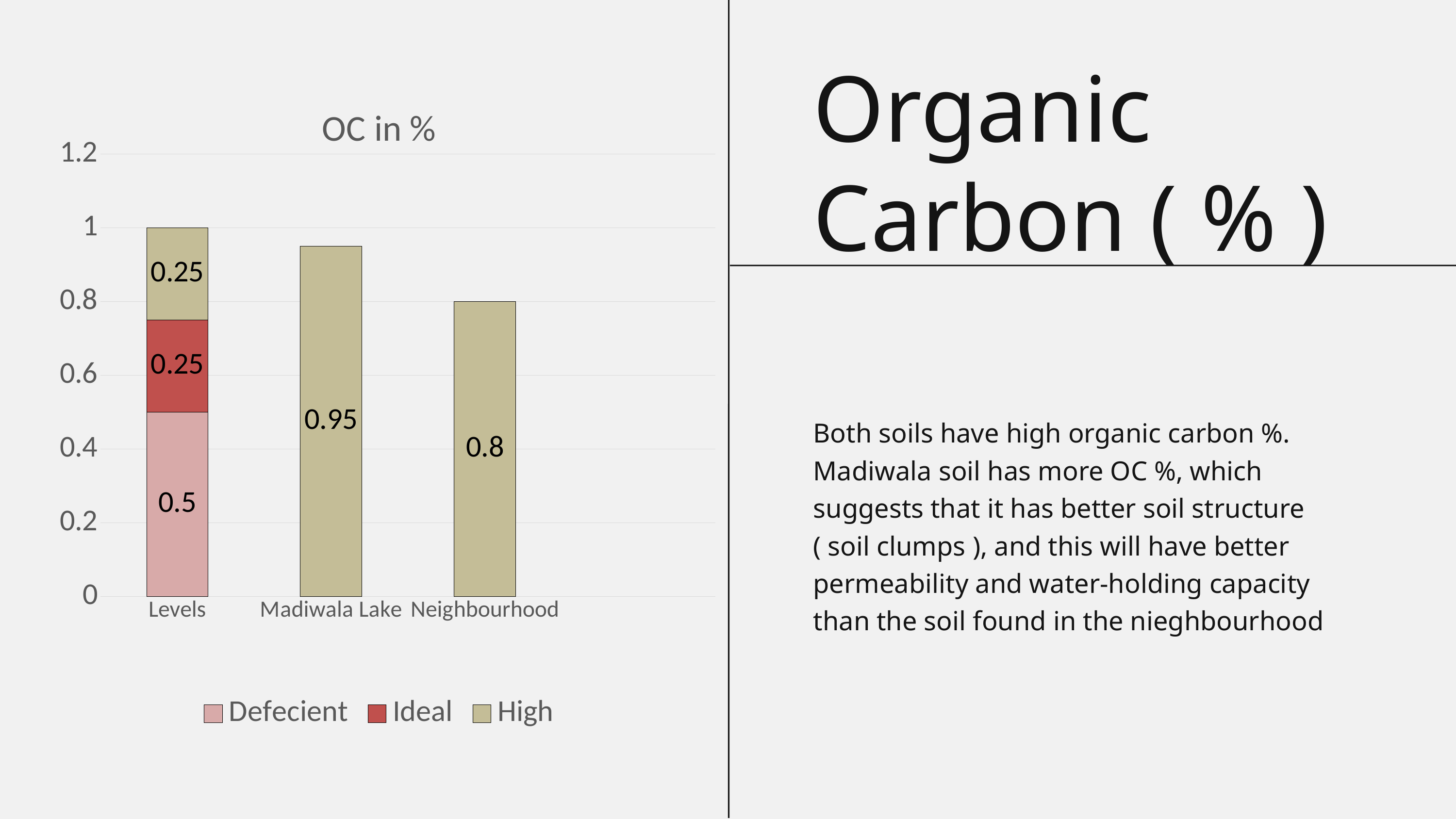
What is the total of the stacked Levels bar? 1 Which is larger, the value for Madiwala Lake or the value for Neighbourhood? Madiwala Lake What is the Ideal value in the Levels bar? 0.25 What is the Defecient value in the Levels bar? 0.5 How many series does the legend list? 3 What is the value for Neighbourhood? 0.8 What is the difference between the values for Madiwala Lake and Neighbourhood? 0.15 What kind of chart is shown on the slide? Stacked bar chart How many categories are shown on the x axis? 3 What is the title of the chart? OC in % What is the value for Madiwala Lake? 0.95 Which legend entry is shown in red? Ideal